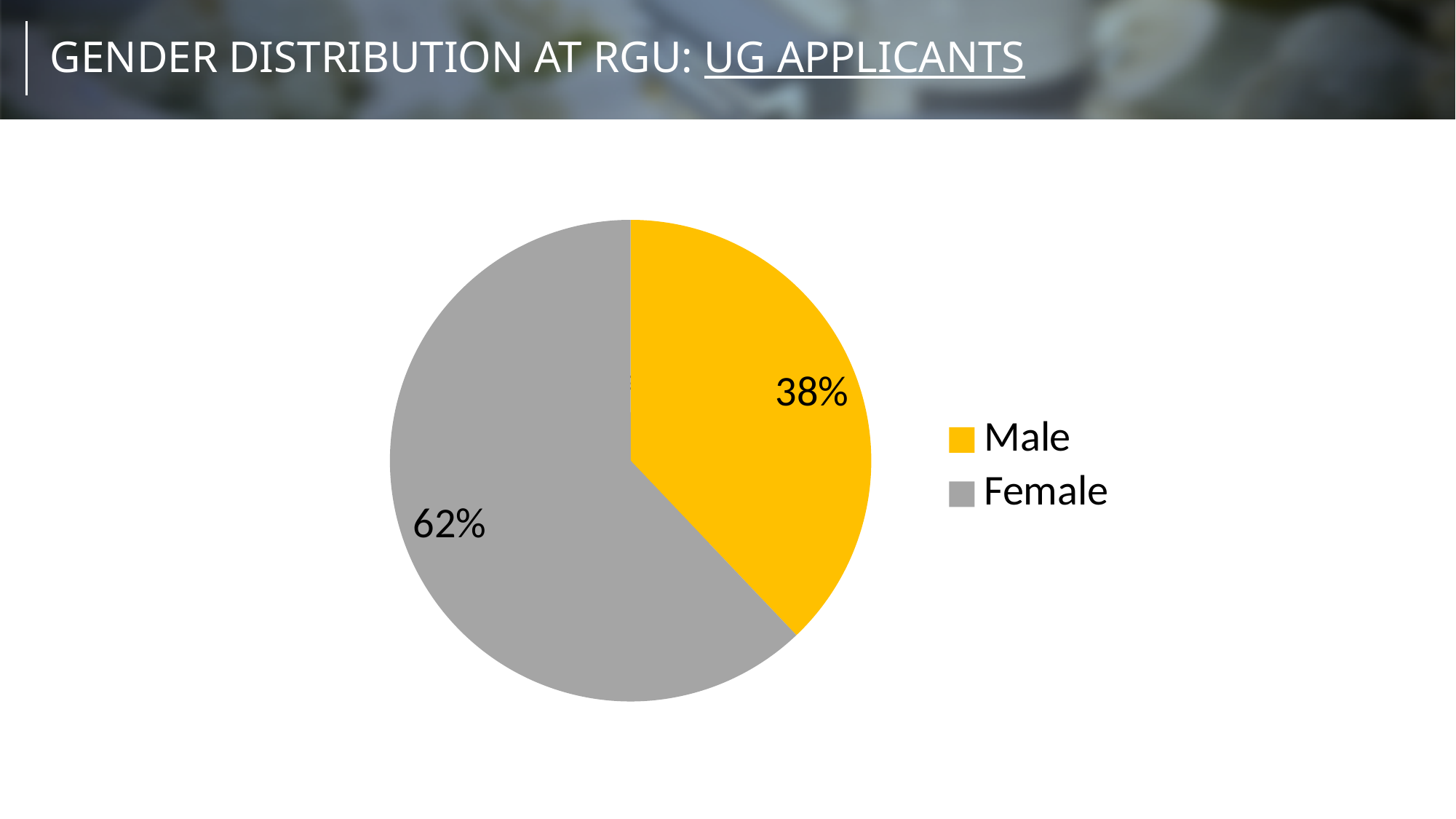
What colour is the Male slice? Yellow Which category has the smallest share of the pie? Male What is the title of the slide? GENDER DISTRIBUTION AT RGU: UG APPLICANTS Which category has the largest share of the pie? Female What kind of chart is shown on the slide? Pie chart What share of the pie does the Female slice represent? 62% What percentage of UG applicants are Male? 38% What percentage of UG applicants are Female? 62% How many categories does the pie chart show? 2 How many entries does the legend list? 2 Which is larger, the Male share or the Female share? Female What is the difference in percentage points between the Female and Male shares? 24